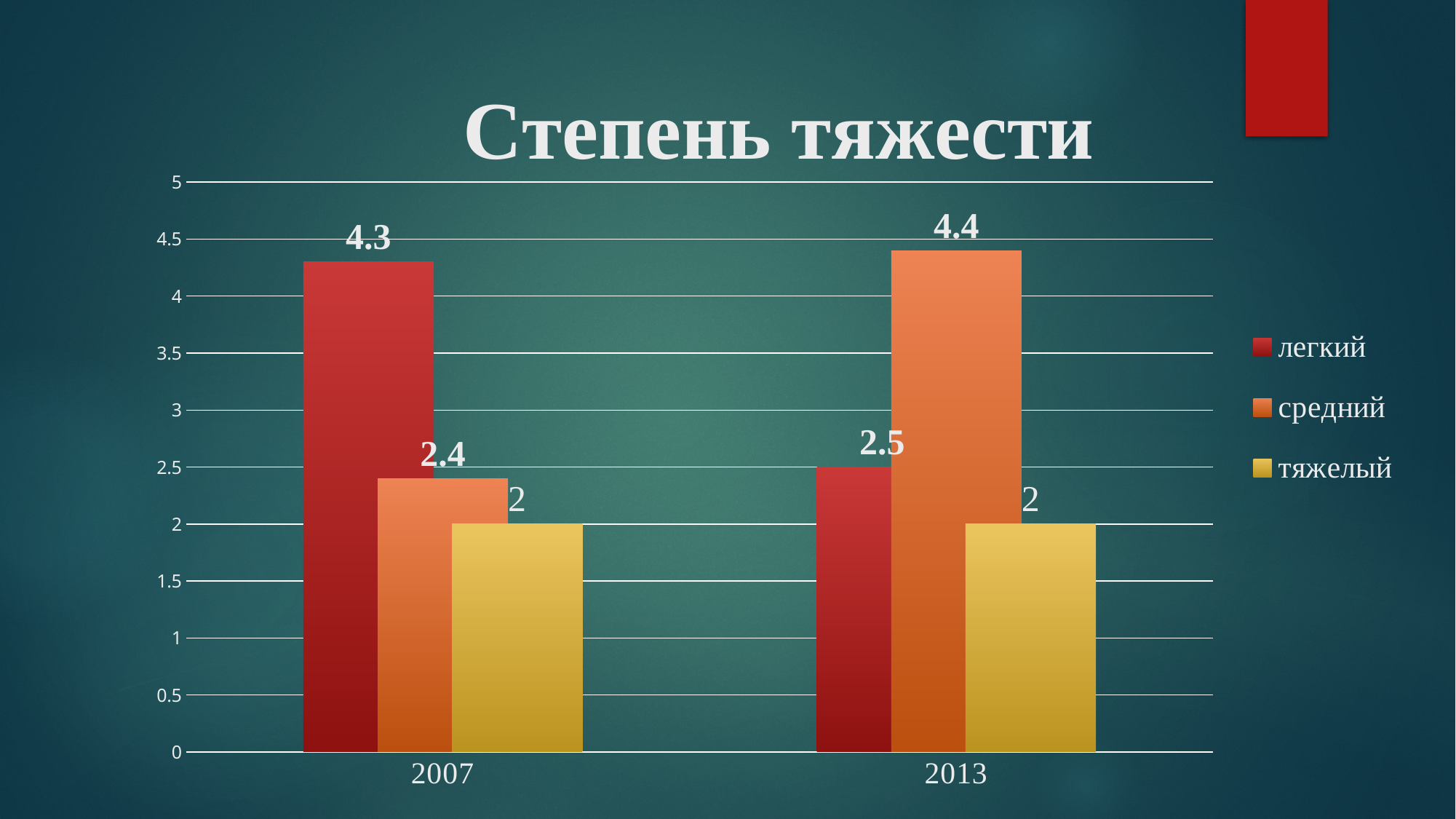
What is the title of the chart? Степень тяжести What is the value for средний in 2013? 4.4 What is the value for тяжелый in 2007? 2 Which series has the lowest value in 2007? тяжелый How many series does the legend list? 3 What is the difference between the легкий values in 2007 and 2013? 1.8 What is the value for легкий in 2007? 4.3 Which series has the highest value in 2013? средний Which is larger: средний in 2007 or средний in 2013? средний in 2013 What is the value for легкий in 2013? 2.5 How many categories are shown on the x axis? 2 What kind of chart is shown on the slide? bar chart